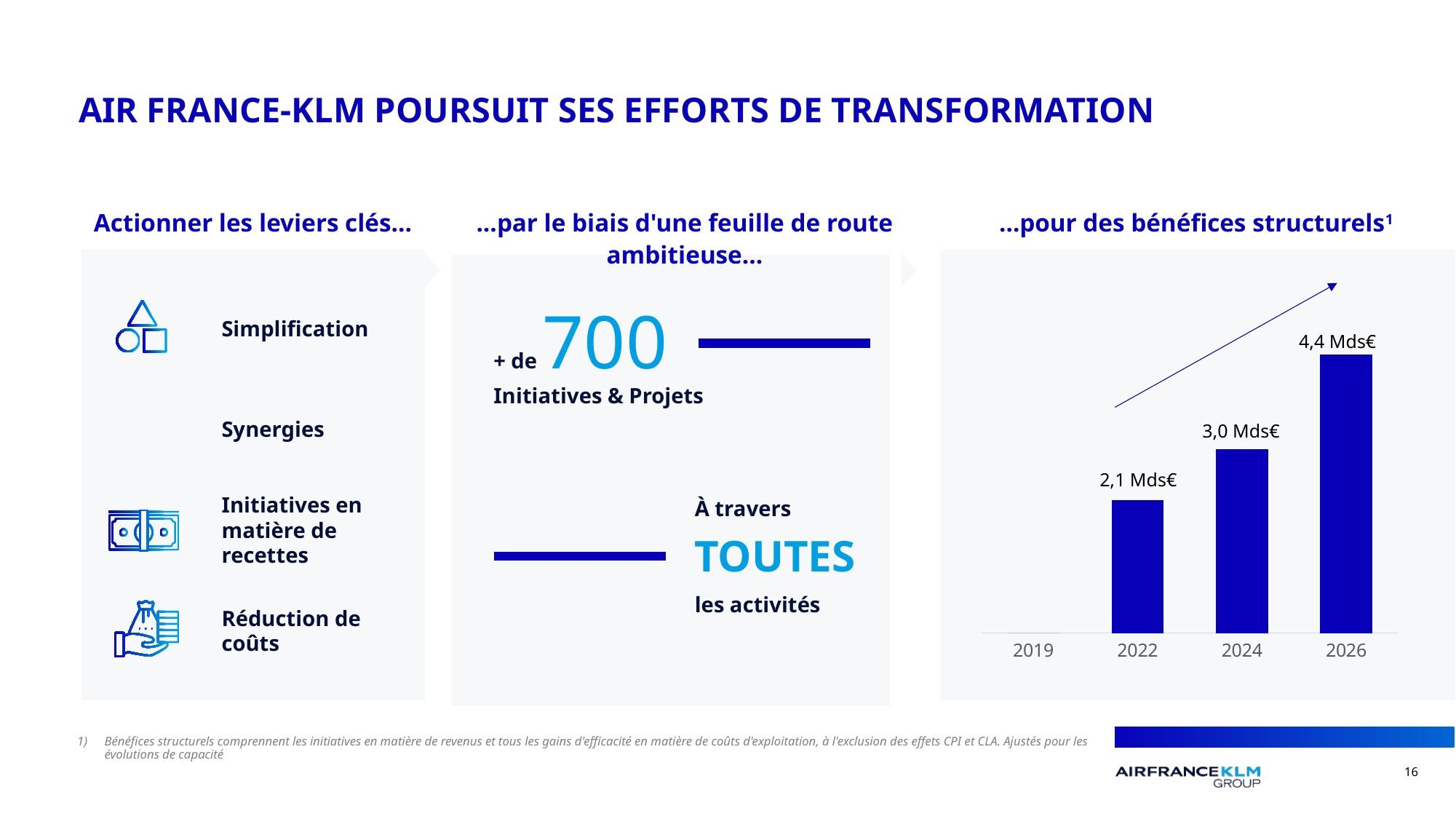
Which year has the highest value in the bar chart on the right? 2026 What kind of chart is shown on the right of the slide? bar chart What is the value shown for 2026 in the bar chart on the right? 4,4 Mds€ How many bars are plotted in the chart on the right? 3 In the bar chart on the right, is the value for 2024 larger or smaller than the value for 2026? smaller Among the years with a bar plotted, which has the lowest value in the chart on the right? 2022 What is the value shown for 2024 in the bar chart on the right? 3,0 Mds€ What is the difference between the 2026 and 2022 values in the bar chart on the right? 2,3 Mds€ What is the difference between the 2024 and 2022 values in the bar chart on the right? 0,9 Mds€ Do the values in the bar chart on the right rise or fall from 2022 to 2026? rise What is the heading above the bar chart on the right? …pour des bénéfices structurels What is the value shown for 2022 in the bar chart on the right? 2,1 Mds€